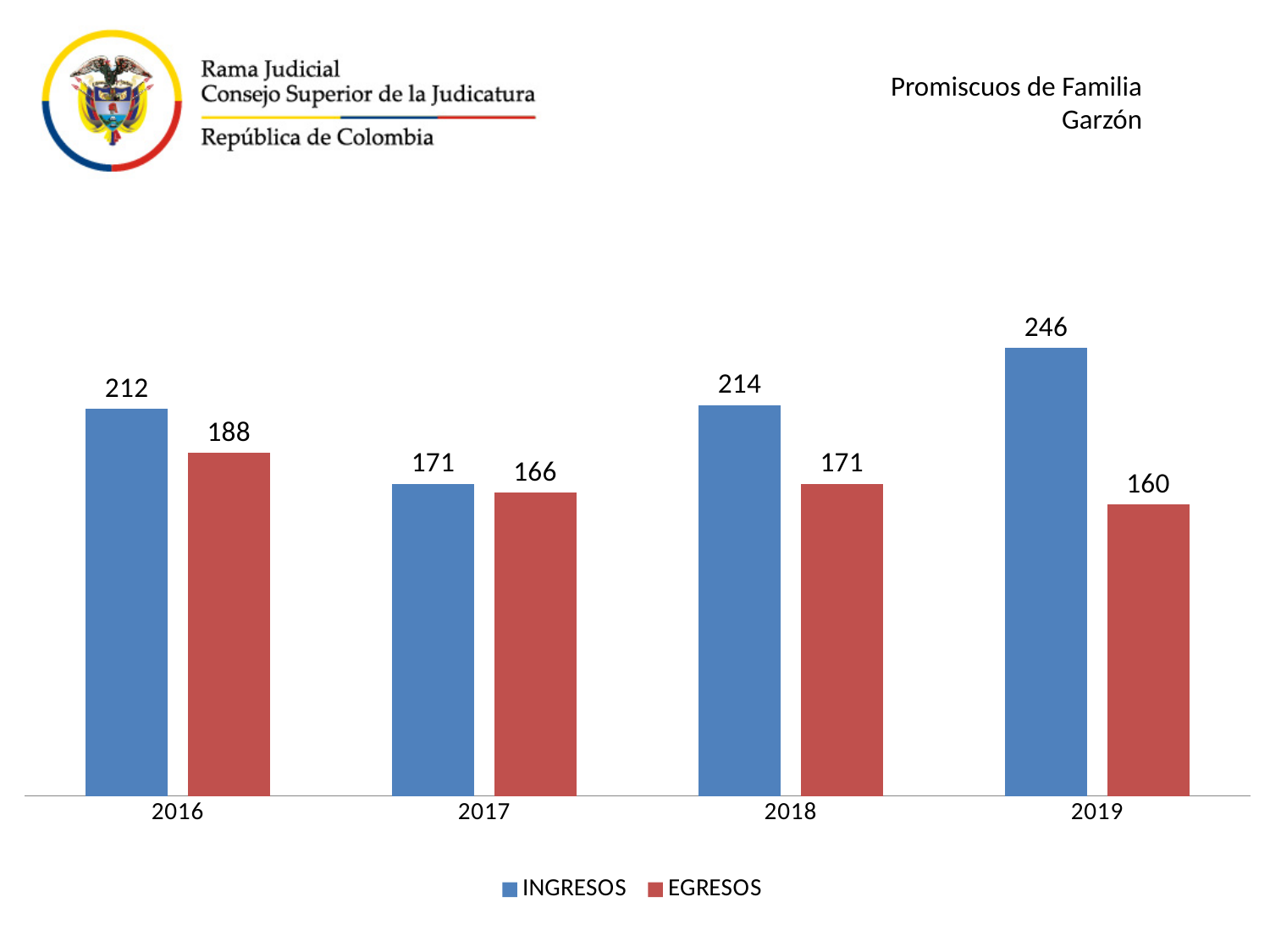
What is the difference between INGRESOS in 2018 and INGRESOS in 2017? 43 What kind of chart is shown on the slide? Bar chart What is the difference between INGRESOS and EGRESOS in 2019? 86 Which is larger in 2016, INGRESOS or EGRESOS? INGRESOS Which colour represents EGRESOS in the chart? Red What is the EGRESOS value for 2017? 166 What is the EGRESOS value for 2019? 160 In which year is EGRESOS lowest? 2019 What is the INGRESOS value for 2016? 212 In which year is INGRESOS highest? 2019 How many years are shown on the x axis? 4 How many series does the legend list? 2